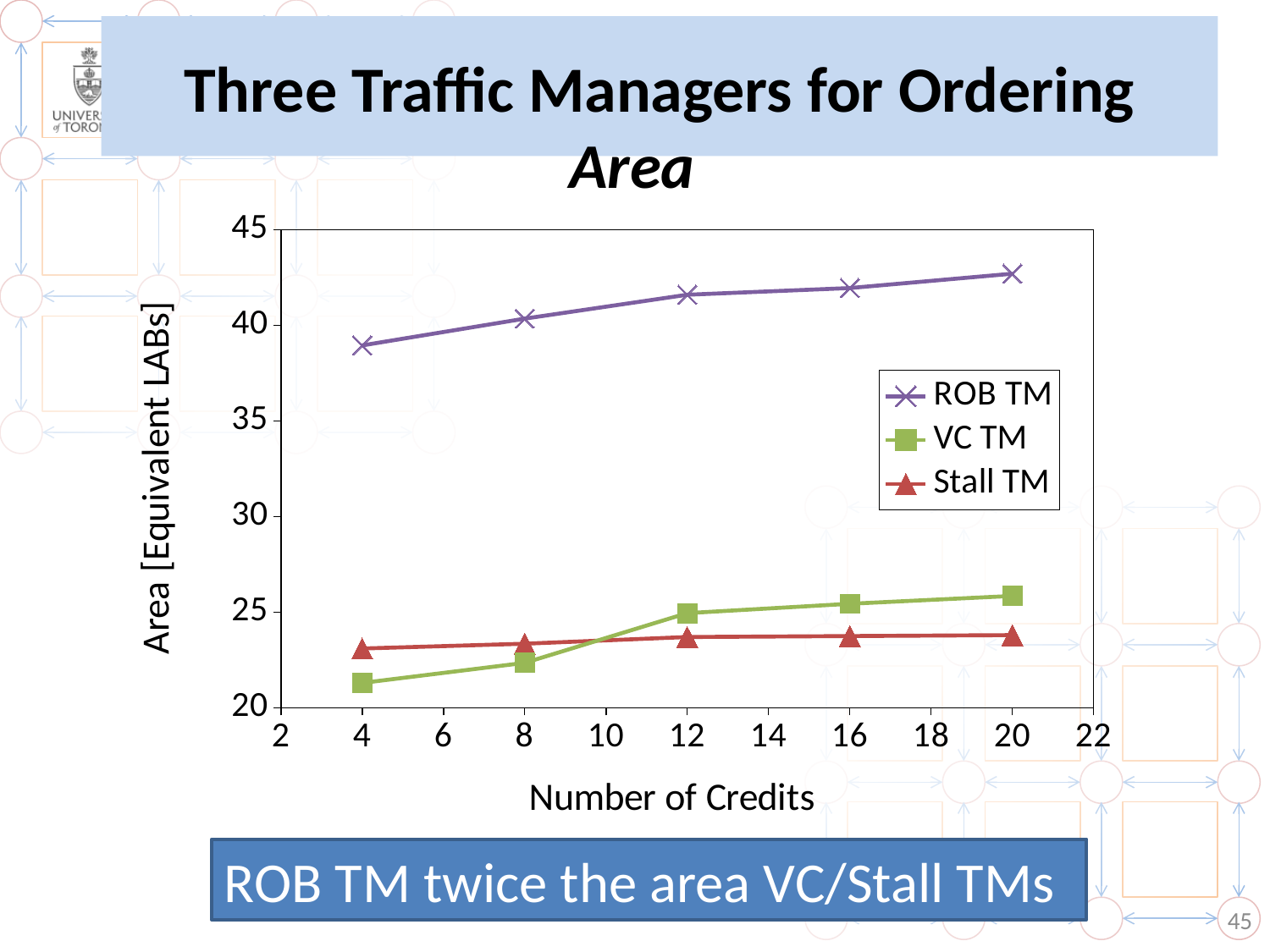
Is the value for ROB TM at 4 credits greater or less than 40? less How many series does the legend list? 3 What kind of chart is shown on the slide? line chart Is the value for ROB TM at 20 credits greater or less than 40? greater What is the title of the x axis? Number of Credits How many data points are plotted for the ROB TM series? 5 At 20 credits, which is larger: VC TM or Stall TM? VC TM Is the value for VC TM at 4 credits greater or less than 25? less Does the ROB TM series rise or fall as the number of credits increases? rise Which series has the highest area across all credit values? ROB TM Which series has the lowest area at 4 credits? VC TM